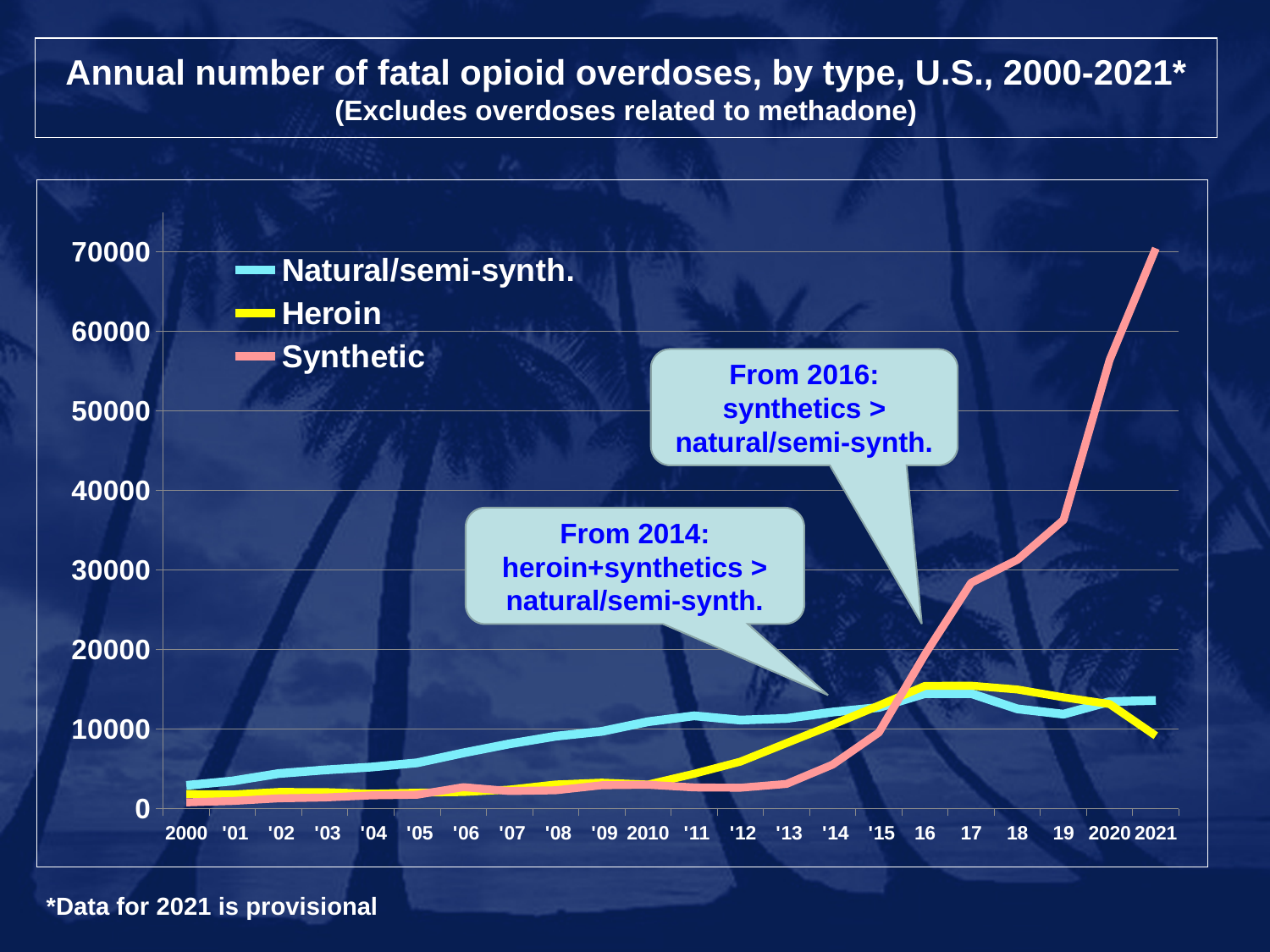
Is the value for Synthetic in 2019 greater or less than 30000? greater Does the Synthetic series rise or fall from 2013 to 2021? rise How many series does the legend list? 3 Which colour is used for the Heroin line? yellow What kind of chart is shown on the slide? line chart How many years are plotted along the x axis? 22 According to the callout, from which year are synthetics greater than natural/semi-synth.? 2016 In 2010, which series is larger: Natural/semi-synth. or Synthetic? Natural/semi-synth. Is the value for Synthetic in 2021 greater or less than 60000? greater Is the value for Heroin in 2021 greater or less than 10000? less Which series has the highest value in 2021? Synthetic Which series has the lowest value in 2021? Heroin